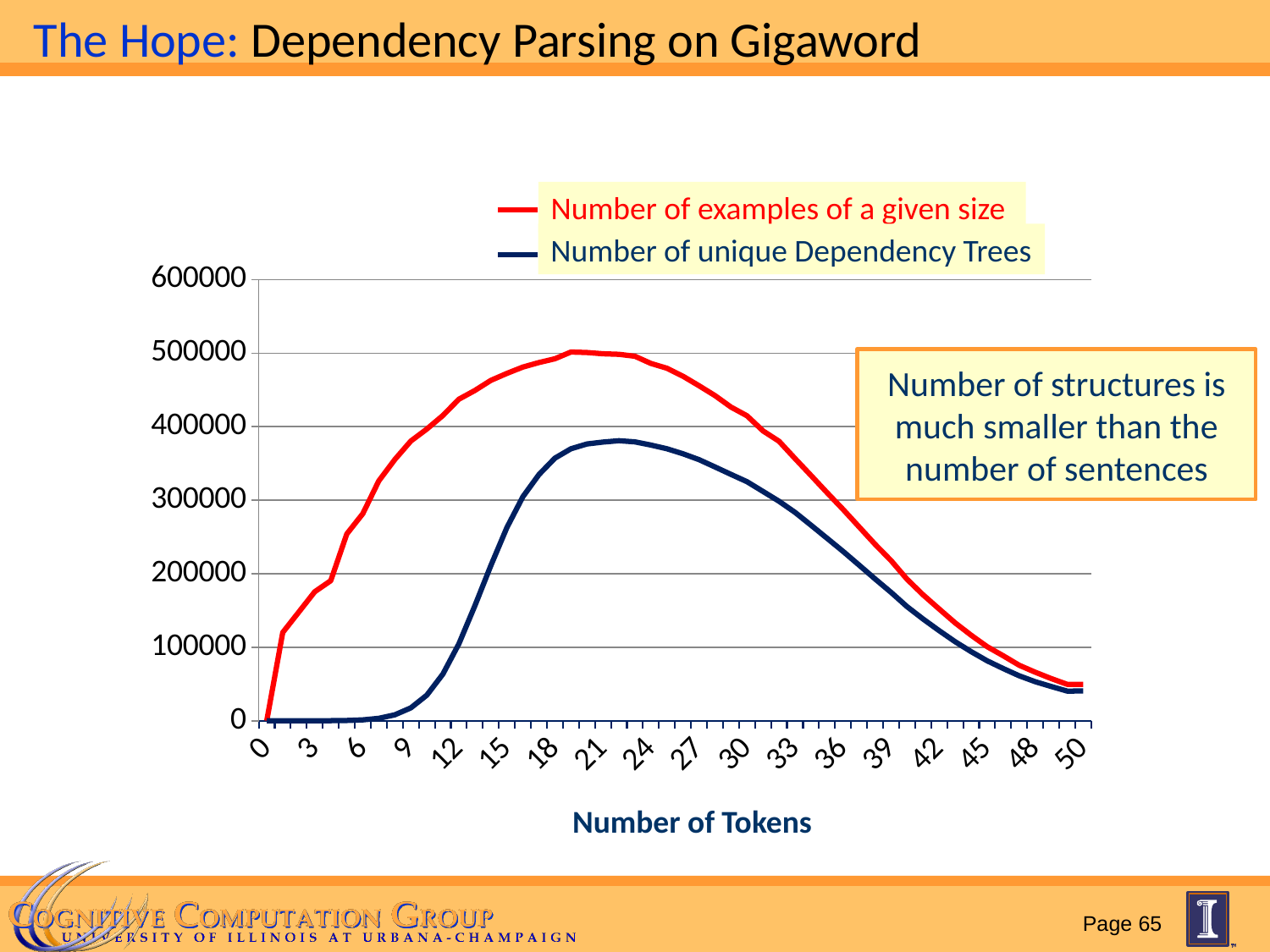
Does the 'Number of unique Dependency Trees' line rise or fall between 24 and 50 tokens? fall Is the value of 'Number of unique Dependency Trees' at 48 tokens greater or less than 100000? less At 21 tokens, which series has the larger value: 'Number of examples of a given size' or 'Number of unique Dependency Trees'? Number of examples of a given size What kind of chart is shown on the slide? line chart Is the value of 'Number of examples of a given size' at 12 tokens greater or less than 400000? greater Is the value of 'Number of unique Dependency Trees' at 21 tokens greater or less than 400000? less How many series does the legend list? 2 What is the title of the x axis? Number of Tokens Which series is drawn in red according to the legend? Number of examples of a given size Which series reaches the higher peak value? Number of examples of a given size